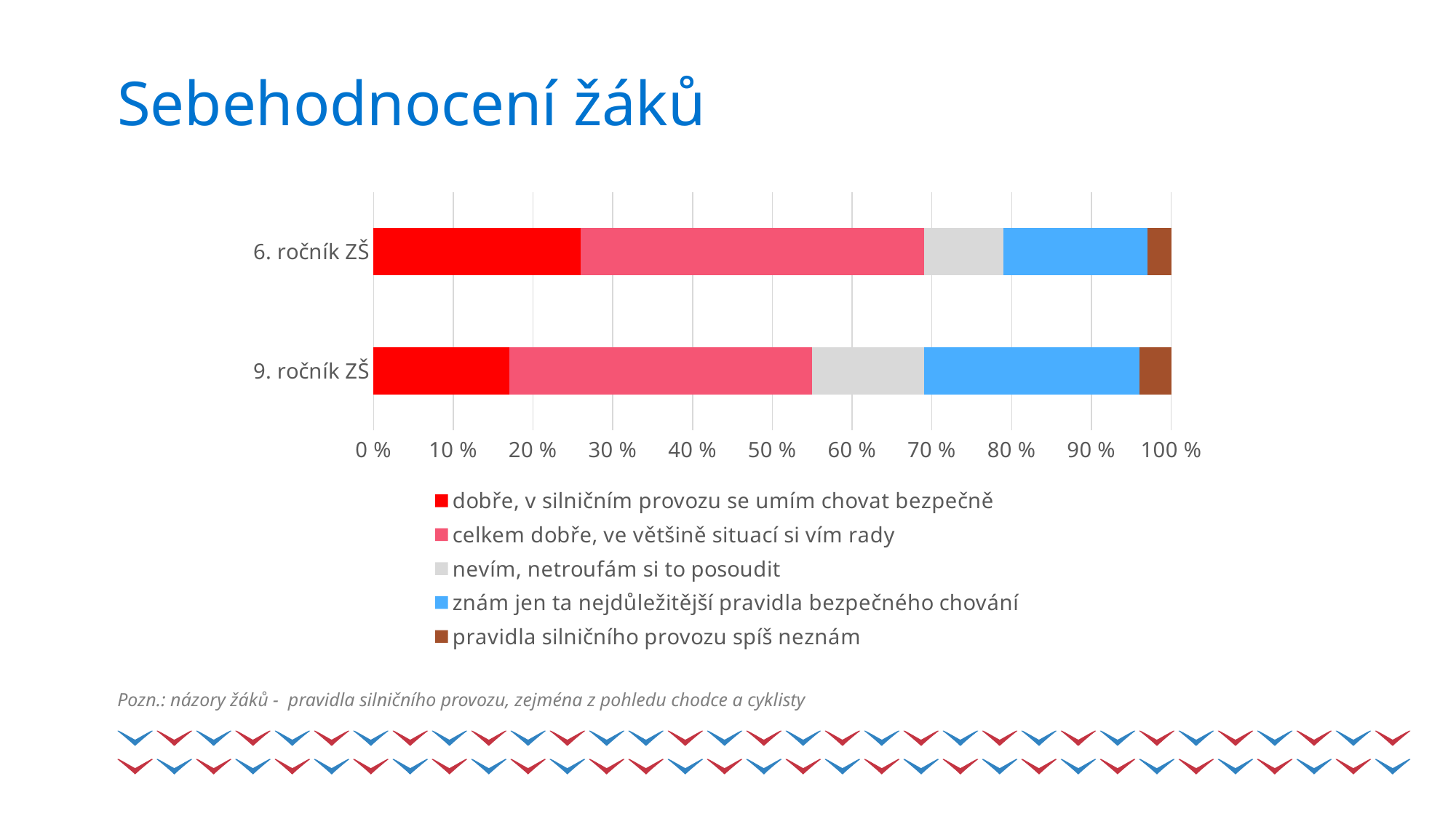
Which legend entry is shown in brown? pravidla silničního provozu spíš neznám How many series does the legend list? 5 Is the value for 'znám jen ta nejdůležitější pravidla bezpečného chování' for 9. ročník ZŠ greater or less than 20 %? greater How many categories (grades) are plotted on the chart? 2 Is the value for 'dobře, v silničním provozu se umím chovat bezpečně' for 9. ročník ZŠ greater or less than 20 %? less What is the title of the slide containing the chart? Sebehodnocení žáků Which grade has the larger share of 'znám jen ta nejdůležitější pravidla bezpečného chování', 6. ročník ZŠ or 9. ročník ZŠ? 9. ročník ZŠ What kind of chart is shown on the slide? stacked bar chart Is the value for 'pravidla silničního provozu spíš neznám' for 6. ročník ZŠ greater or less than 10 %? less Which grade has the larger share of 'dobře, v silničním provozu se umím chovat bezpečně', 6. ročník ZŠ or 9. ročník ZŠ? 6. ročník ZŠ What is the total of the stacked bar for 9. ročník ZŠ? 100 %